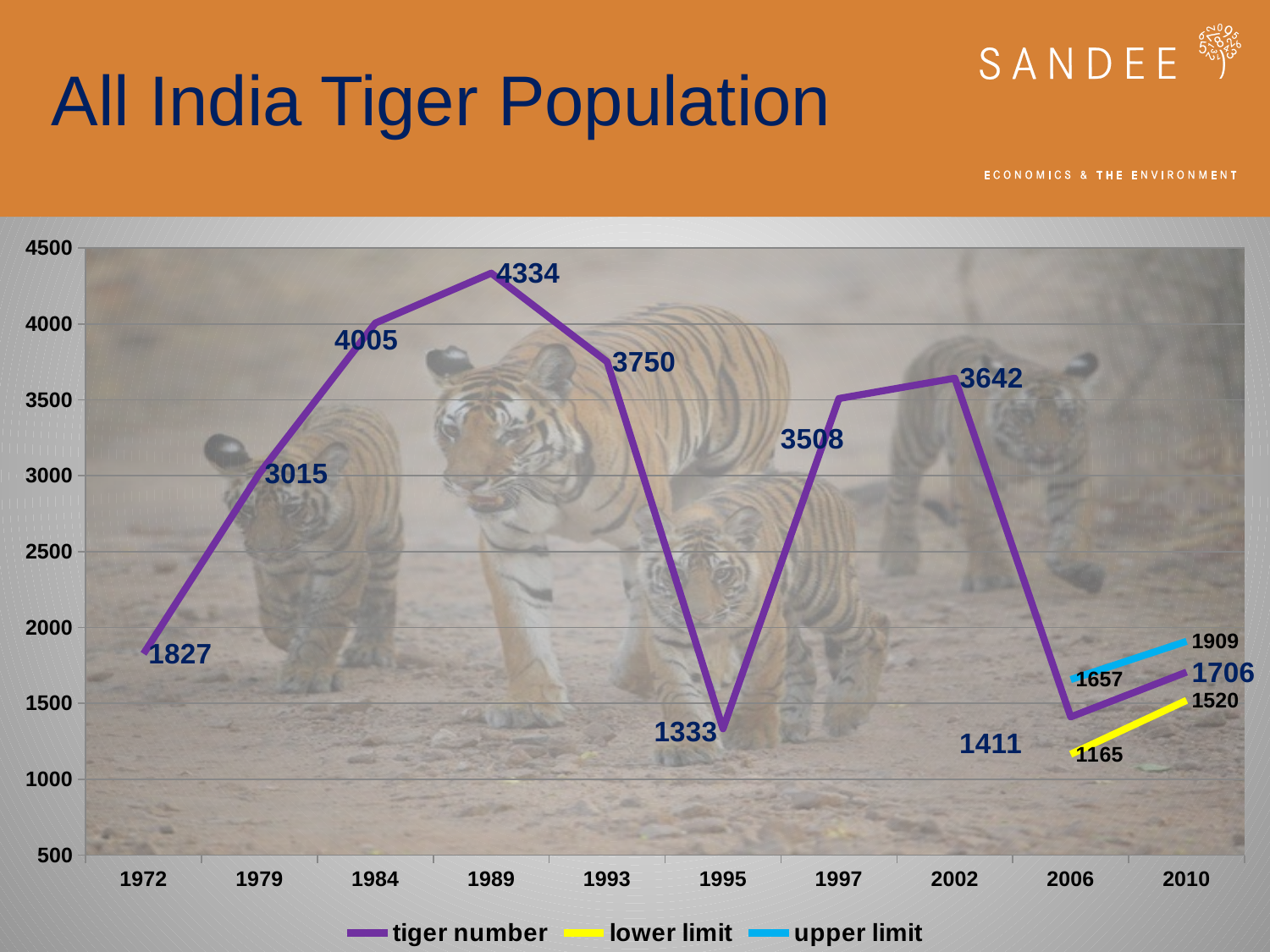
What is the upper limit value for 2010? 1909 Which year has a larger tiger number, 1997 or 2002? 2002 What is the lower limit value for 2006? 1165 In which year is the tiger number highest? 1989 How many series does the legend list? 3 What is the tiger number for 1972? 1827 What is the tiger number for 1989? 4334 In which year is the tiger number lowest? 1995 How many years are shown on the x axis? 10 Does the tiger number rise or fall from 2002 to 2006? fall What is the difference between the tiger number in 1989 and in 1995? 3001 What kind of chart is shown on the slide? line chart